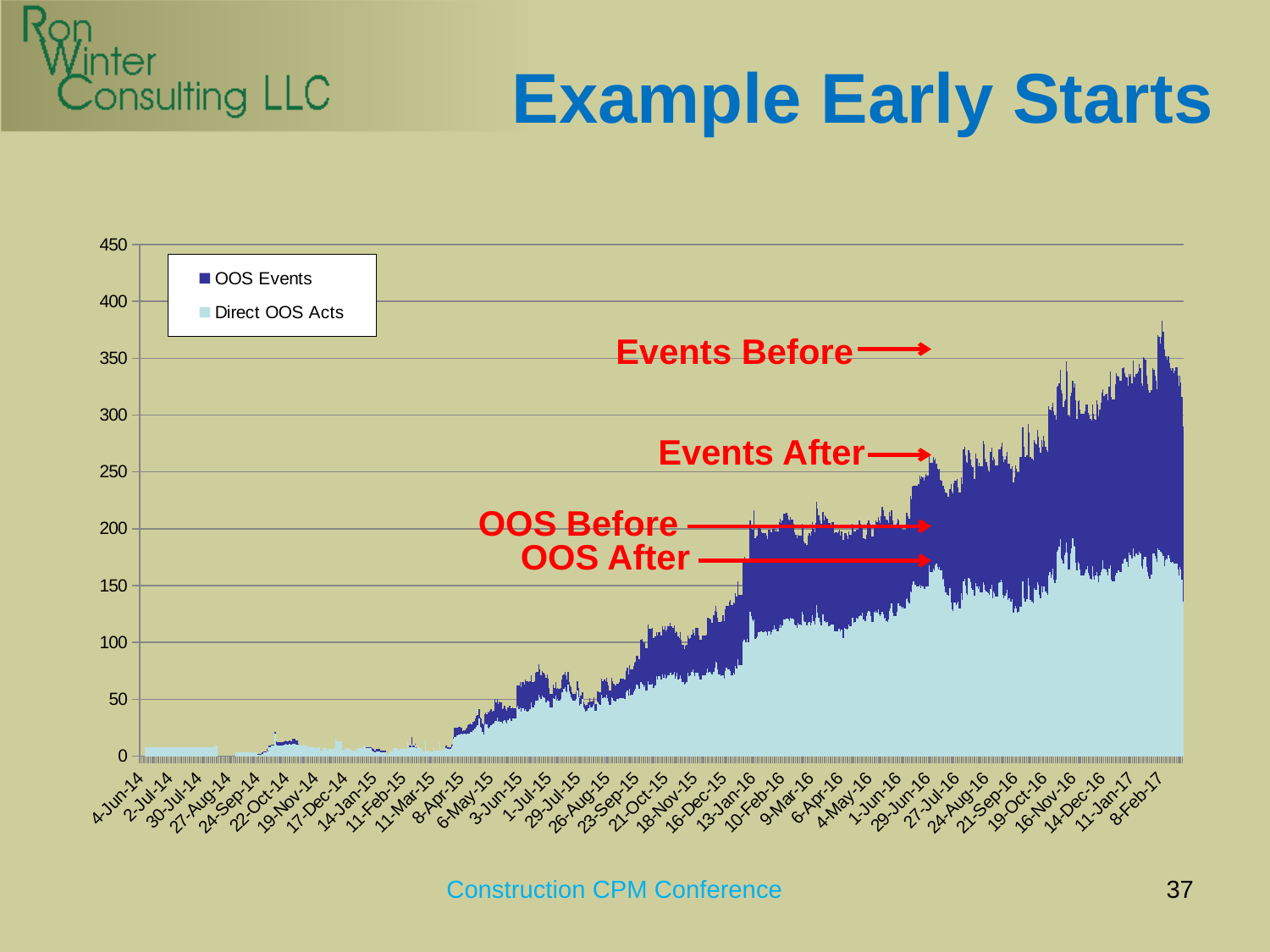
Is the total stacked value around 11-Jan-17 greater or less than 300? greater What is the first date label on the x axis? 4-Jun-14 What is the last date label on the x axis? 8-Feb-17 How many series does the legend list? 2 Is the total stacked value around 4-Jun-14 greater or less than 50? less Which series is drawn in the lighter blue colour? Direct OOS Acts What kind of chart is shown on the slide? area chart Do the plotted values generally rise or fall from left to right along the x axis? rise What are the two series named in the legend? OOS Events and Direct OOS Acts Is the total stacked value around 8-Apr-15 greater or less than 50? less What is the highest value shown on the vertical axis? 450